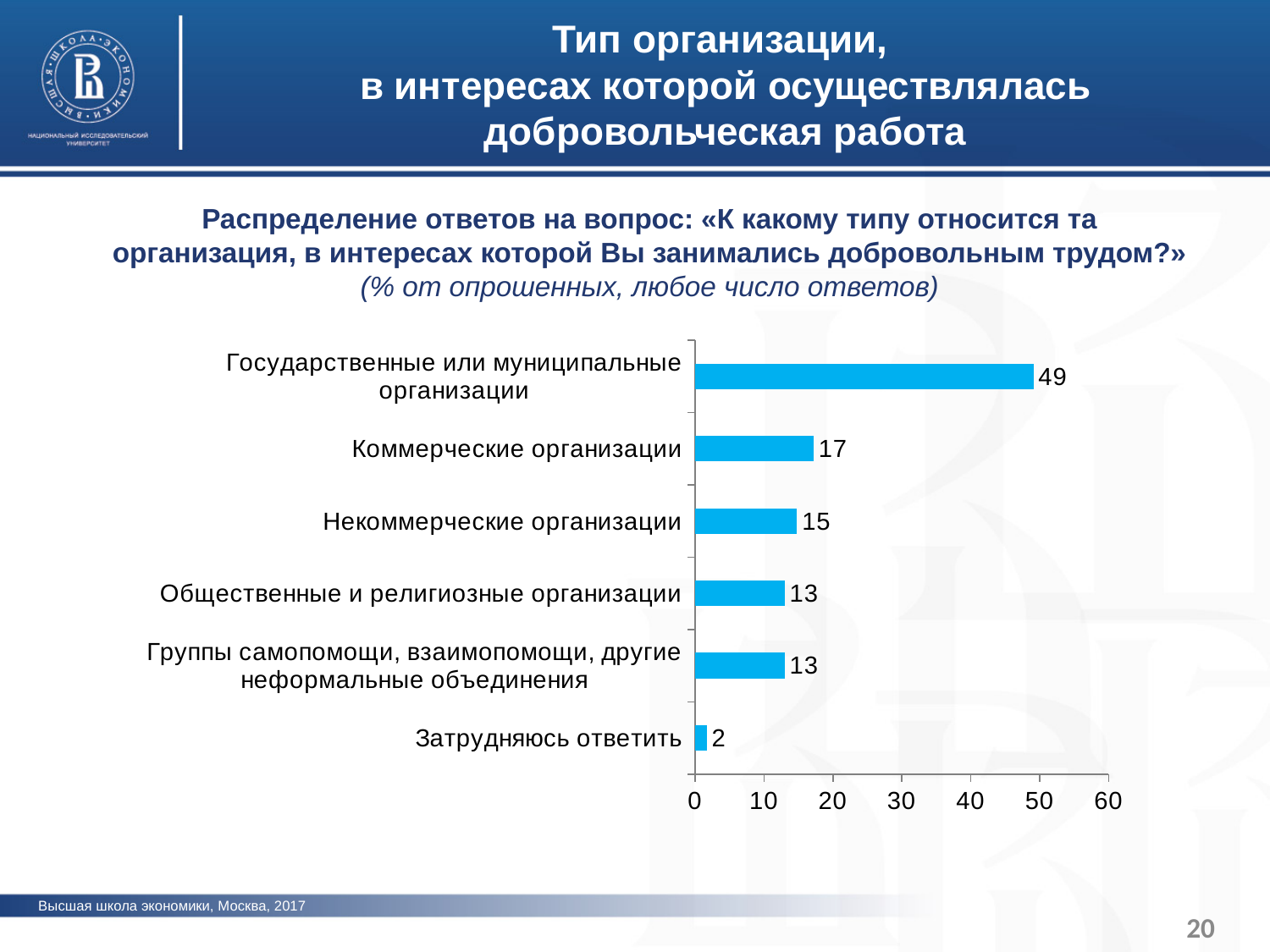
What is the difference between the values for «Государственные или муниципальные организации» and «Коммерческие организации»? 32 What value is shown for «Затрудняюсь ответить»? 2 What is the maximum value shown on the horizontal axis? 60 How many categories are shown in the chart? 6 Is the value for «Государственные или муниципальные организации» greater or less than 40? greater What value is shown for «Некоммерческие организации»? 15 Which category has the highest value? Государственные или муниципальные организации What kind of chart is shown on the slide? Bar chart What value is shown for «Государственные или муниципальные организации»? 49 Which category has the lowest value? Затрудняюсь ответить Which is larger: the value for «Коммерческие организации» or for «Некоммерческие организации»? Коммерческие организации What value is shown for «Коммерческие организации»? 17